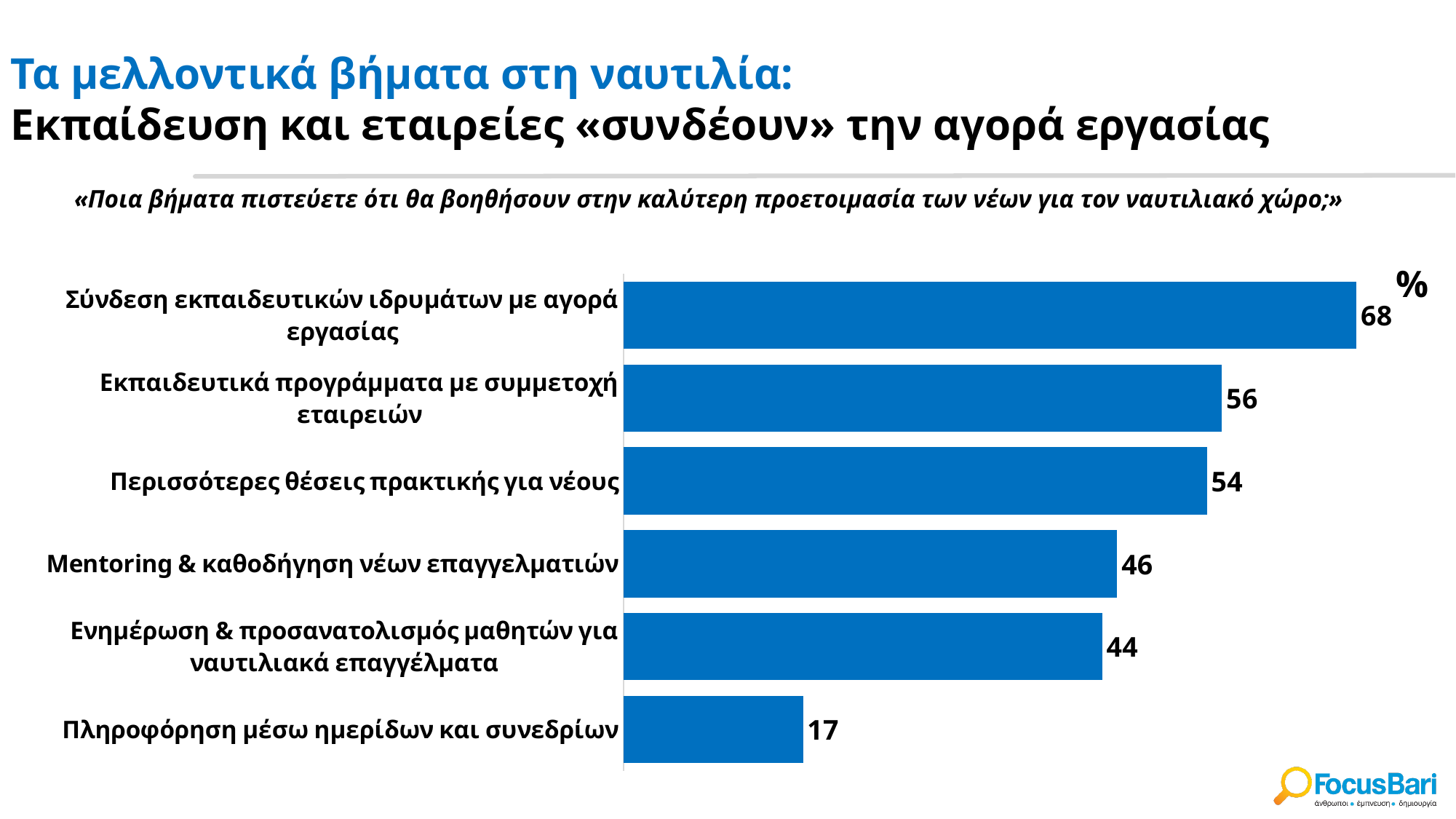
What is the difference between the highest and lowest values in the chart? 51 What unit is indicated at the top right of the chart? % What is the difference between the values for «Εκπαιδευτικά προγράμματα με συμμετοχή εταιρειών» and «Περισσότερες θέσεις πρακτικής για νέους»? 2 What is the value for «Πληροφόρηση μέσω ημερίδων και συνεδρίων»? 17 How many categories are shown in the chart? 6 What is the value for «Σύνδεση εκπαιδευτικών ιδρυμάτων με αγορά εργασίας»? 68 What kind of chart is shown on the slide? Bar chart Which is larger: the value for «Mentoring & καθοδήγηση νέων επαγγελματιών» or for «Ενημέρωση & προσανατολισμός μαθητών για ναυτιλιακά επαγγέλματα»? Mentoring & καθοδήγηση νέων επαγγελματιών What is the value for «Mentoring & καθοδήγηση νέων επαγγελματιών»? 46 Which category has the lowest value? Πληροφόρηση μέσω ημερίδων και συνεδρίων What is the value for «Ενημέρωση & προσανατολισμός μαθητών για ναυτιλιακά επαγγέλματα»? 44 Which category has the highest value? Σύνδεση εκπαιδευτικών ιδρυμάτων με αγορά εργασίας